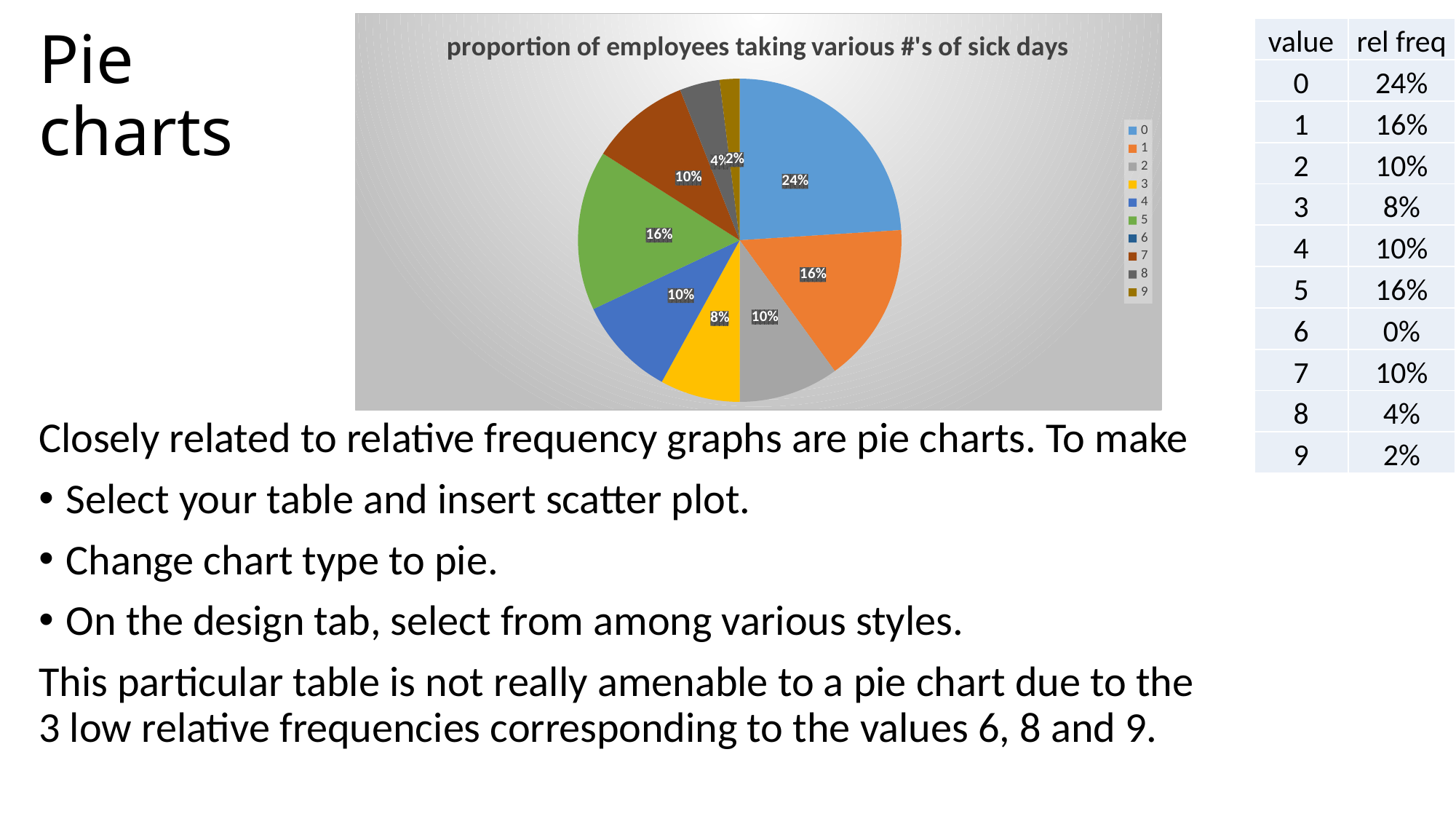
What percentage of the pie does category 8 represent? 4% How many entries does the legend of the pie chart list? 10 What is the title of the pie chart? proportion of employees taking various #'s of sick days Which category has the smallest visible slice of the pie? 9 What percentage of the pie does category 5 represent? 16% What percentage of the pie does category 3 represent? 8% What percentage of the pie does category 0 represent? 24% Which has the larger share, category 3 or category 4? 4 Which category has the largest slice of the pie? 0 Which has the larger share, category 5 or category 7? 5 What is the difference between the shares for category 0 and category 1? 8% What kind of chart is shown on the slide? pie chart